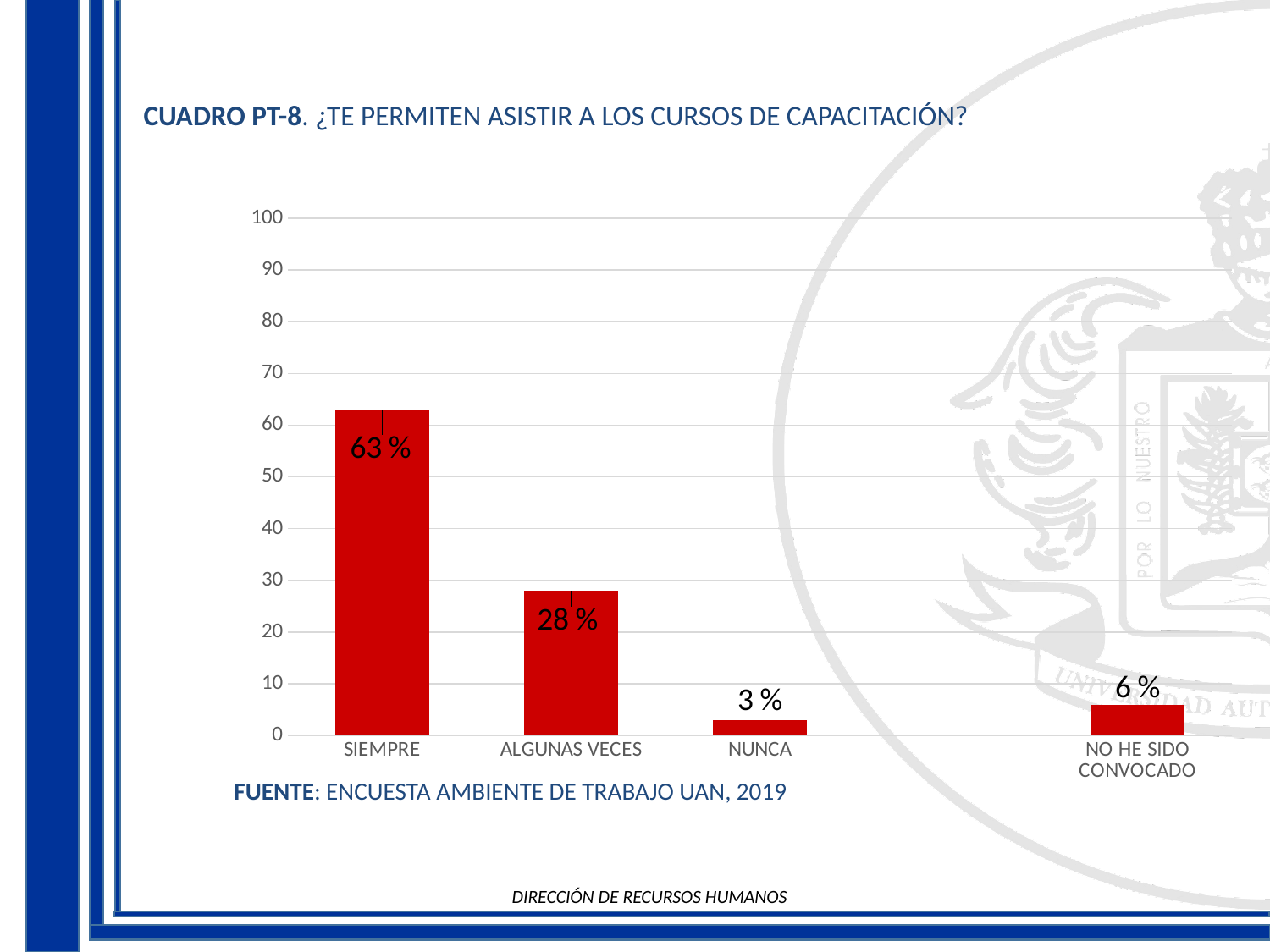
What is the value for NUNCA? 3 % What is the value for SIEMPRE? 63 % What kind of chart is shown on the slide? bar chart Which is larger, the value for NO HE SIDO CONVOCADO or the value for NUNCA? NO HE SIDO CONVOCADO Which category has the lowest value? NUNCA Which category has the highest value? SIEMPRE How many categories are shown on the x axis? 4 Is the value for SIEMPRE greater or less than 50? greater What is the value for ALGUNAS VECES? 28 % What is the value for NO HE SIDO CONVOCADO? 6 % What is the difference between the values for SIEMPRE and ALGUNAS VECES? 35 % What is the title of the chart? CUADRO PT-8. ¿TE PERMITEN ASISTIR A LOS CURSOS DE CAPACITACIÓN?